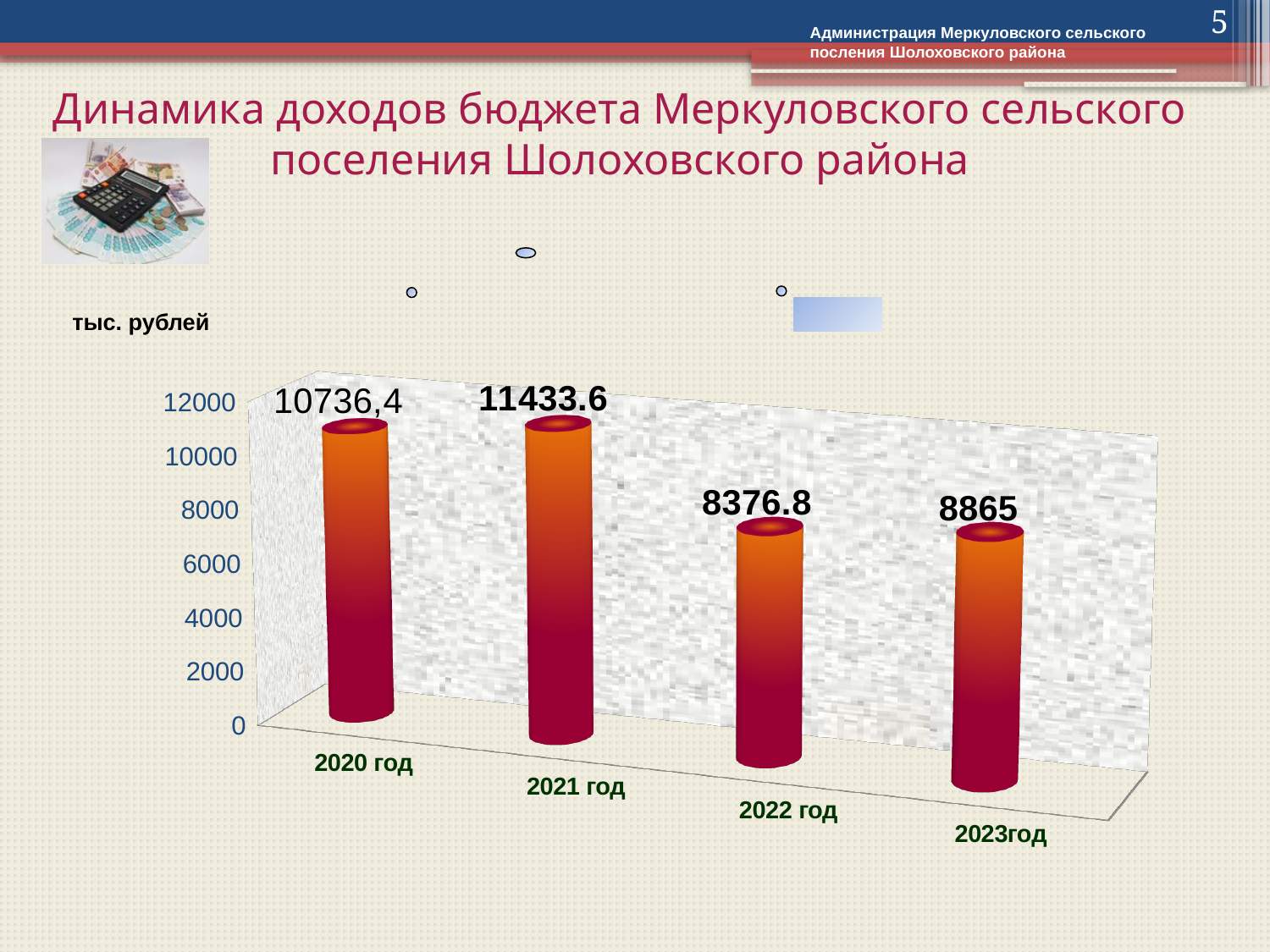
What is the difference between the values for 2023год and 2022 год? 488.2 In what units are the values on the chart expressed? тыс. рублей What is the value shown for 2022 год? 8376.8 What is the value shown for 2021 год? 11433.6 What kind of chart is shown on the slide? Bar chart What is the budget revenue value shown for 2020 год? 10736,4 Which year has the lowest budget revenue? 2022 год Which year has the highest budget revenue? 2021 год How many years (categories) are plotted on the chart? 4 What is the value shown for 2023год? 8865 By how much does the value for 2021 год exceed the value for 2020 год? 697.2 Which is larger, the value for 2020 год or the value for 2023год? 2020 год